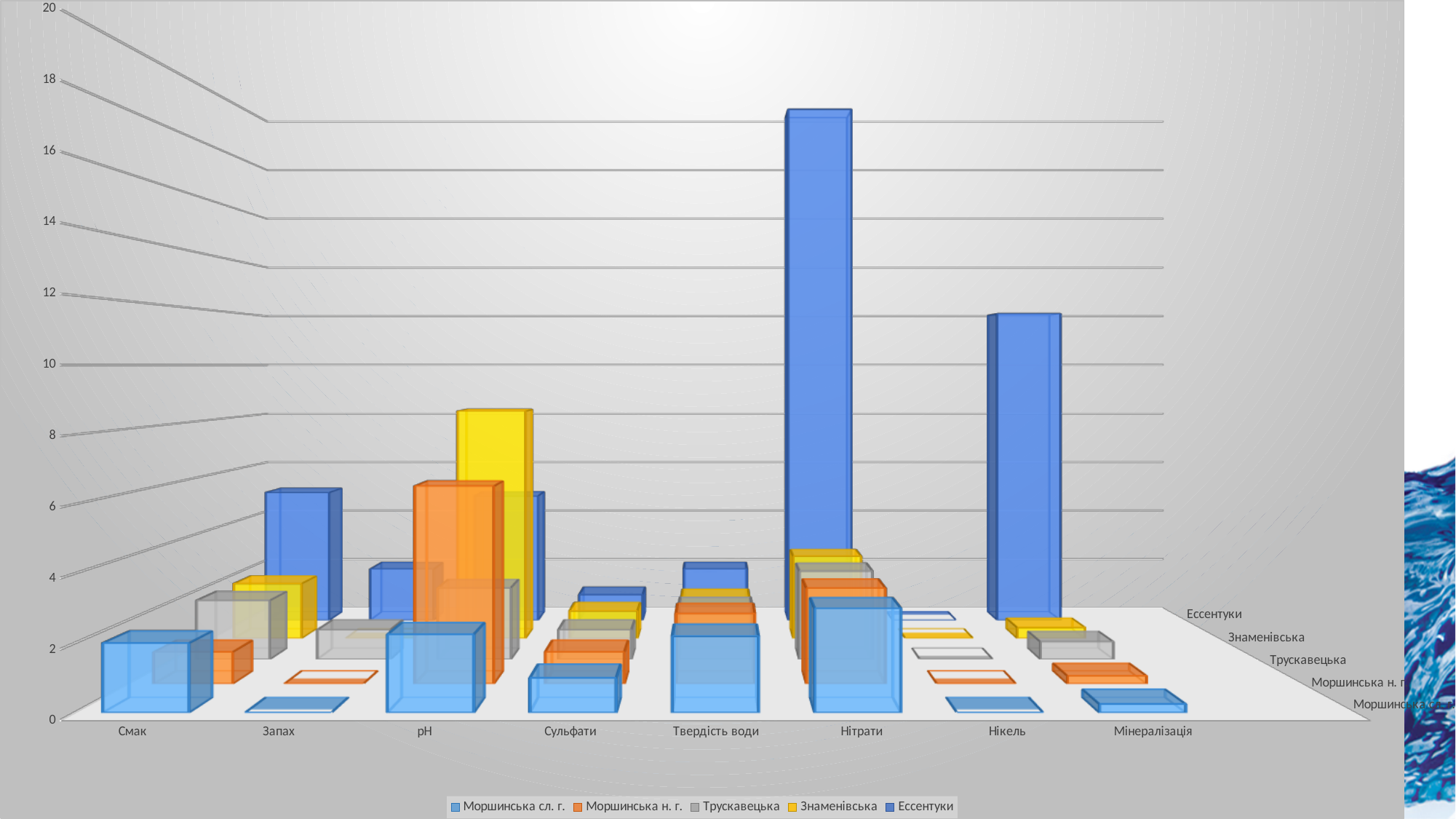
How many series does the legend list? 5 For which category is the Ессентуки bar the highest? Нітрати Which series has the highest value for Нітрати? Ессентуки What kind of chart is shown on the slide? bar chart Which colour represents the Знаменівська series in the legend? yellow Is the Моршинська сл. г. value for Смак greater or less than 4? less Which series has the highest value for pH? Знаменівська Is the Знаменівська value for pH greater or less than 6? greater Which is larger for Ессентуки: the value for Нітрати or the value for Нікель? Нітрати Is the Ессентуки value for Нітрати greater or less than 14? greater How many categories are shown along the x axis? 8